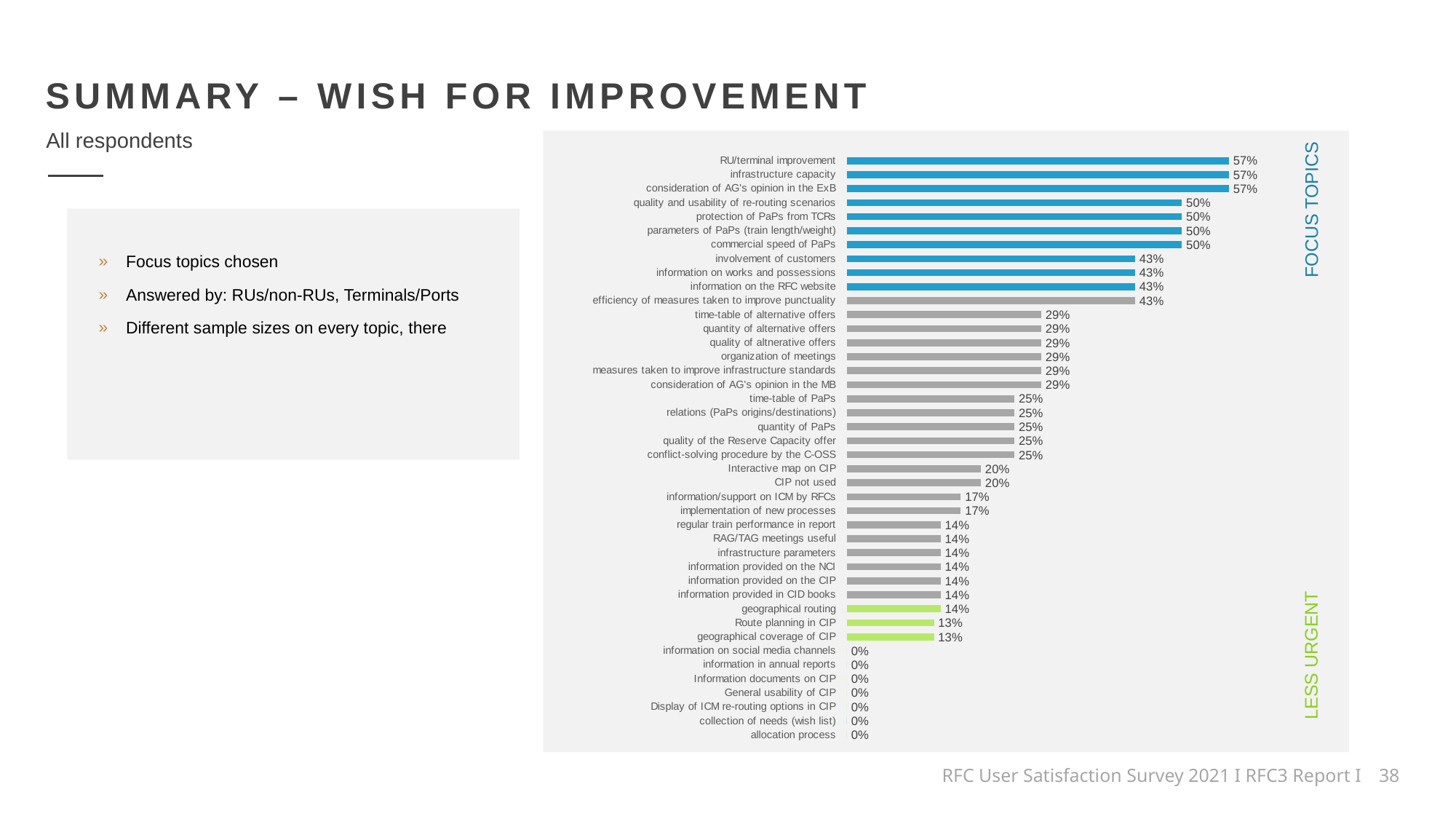
Which has a larger value, 'geographical routing' or 'information on the RFC website'? information on the RFC website How many categories are plotted on the chart? 42 What is the value for 'involvement of customers'? 43% Which has a larger value, 'organization of meetings' or 'Interactive map on CIP'? organization of meetings What is the highest value shown on the chart? 57% What is the value for 'Route planning in CIP'? 13% What kind of chart is shown on the slide? bar chart What is the difference between the values for 'RU/terminal improvement' and 'commercial speed of PaPs'? 7% What is the value for 'CIP not used'? 20% What is the lowest value shown on the chart? 0% What is the difference between the values for 'time-table of PaPs' and 'implementation of new processes'? 8% What is the value for 'allocation process'? 0%